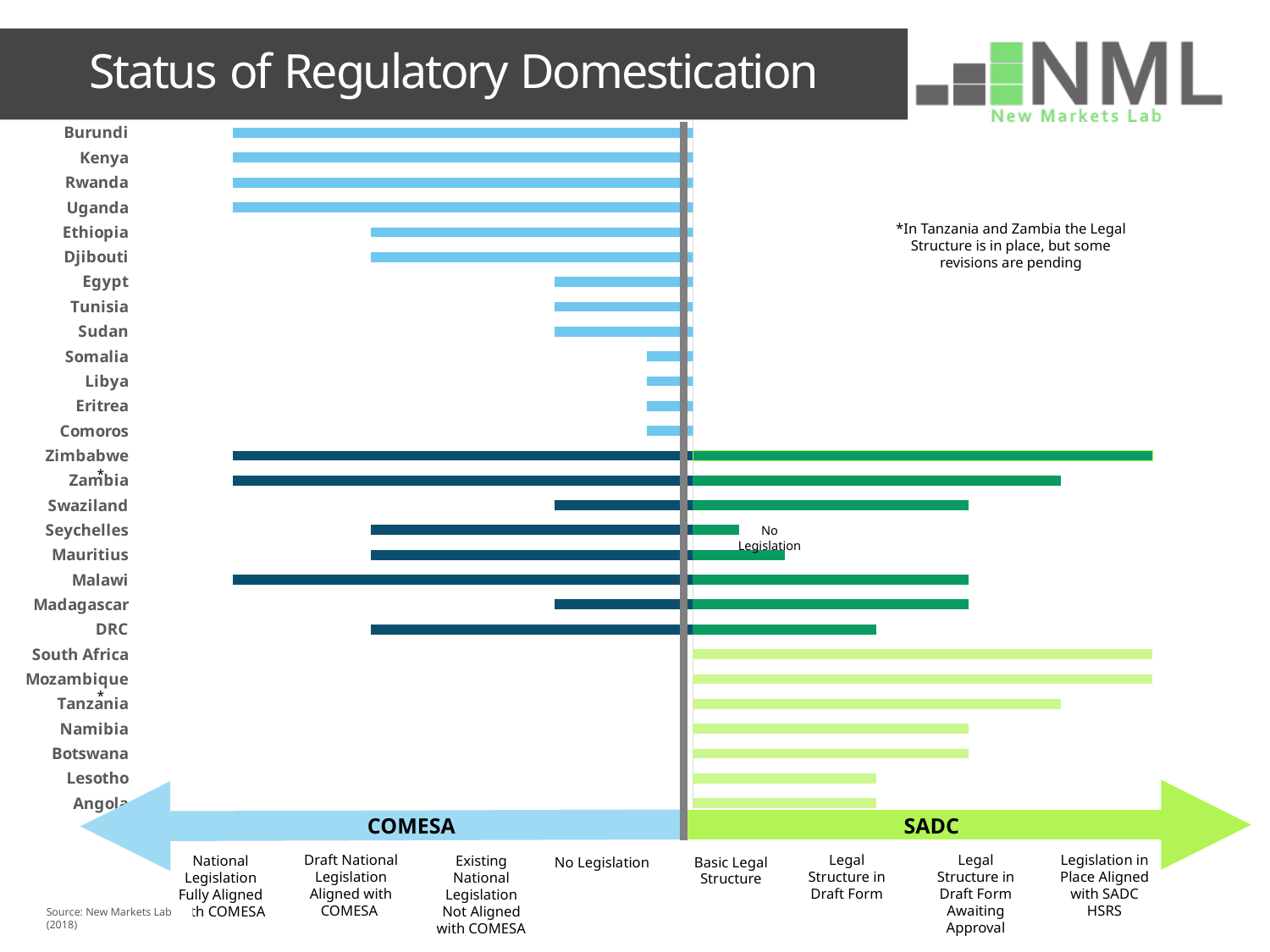
What kind of chart is shown on the slide? Bar chart Which COMESA status does Ethiopia's bar reach? Draft National Legislation Aligned with COMESA Which two regional blocs are shown on the left and right sides of the chart? COMESA and SADC Which SADC status does Namibia's bar reach? Legal Structure in Draft Form Awaiting Approval Which COMESA status does Egypt's bar reach? Existing National Legislation Not Aligned with COMESA Which COMESA status does Somalia's bar reach? No Legislation Which SADC status does South Africa's bar reach? Legislation in Place Aligned with SADC HSRS Which country has the shortest bar on the SADC side of the chart? Seychelles How many countries are listed on the vertical axis of the chart? 28 How many countries have bars on both the COMESA and SADC sides of the chart? 8 What is the title of the chart on the slide? Status of Regulatory Domestication Which COMESA status does Burundi's bar reach? National Legislation Fully Aligned with COMESA